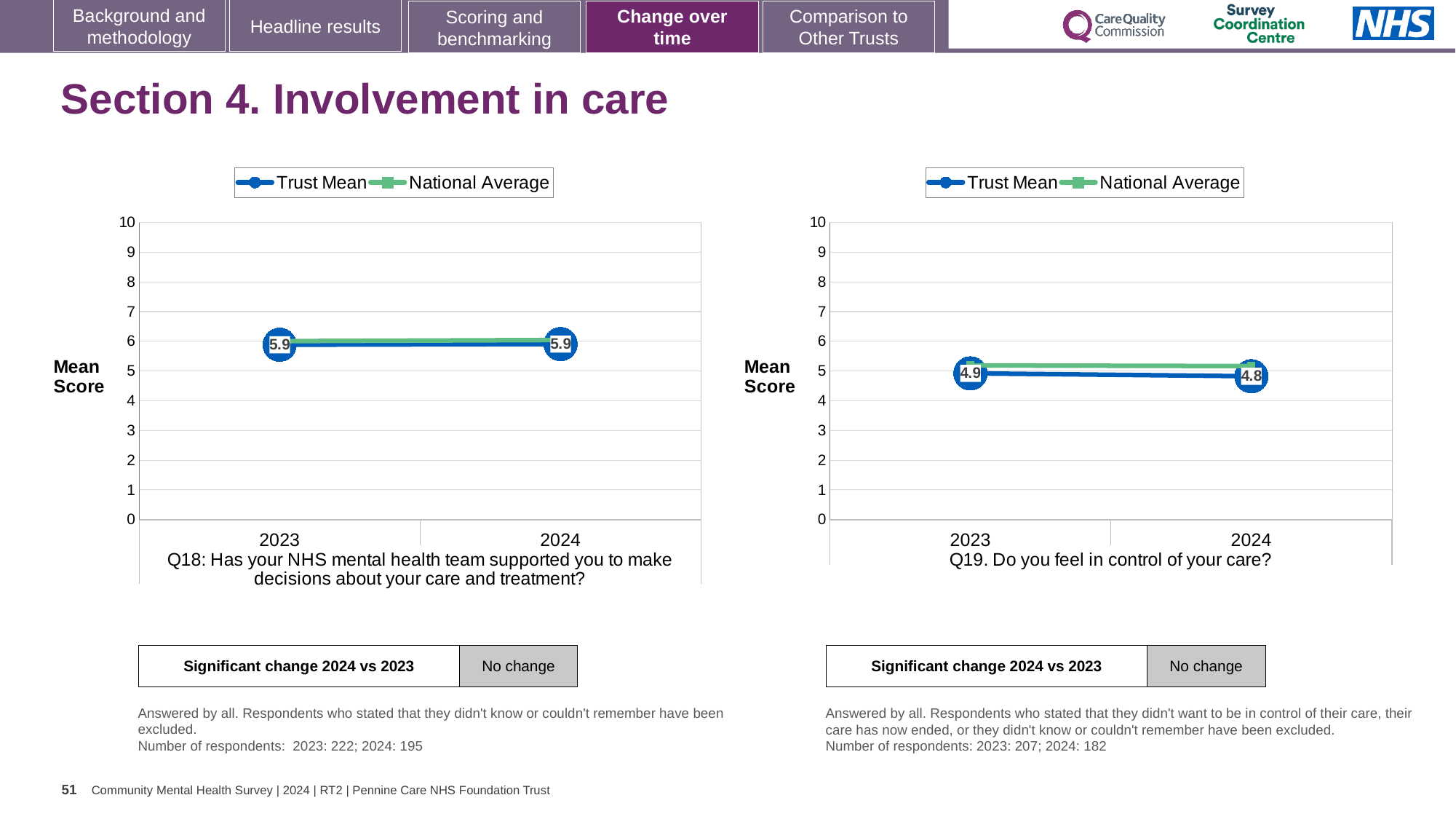
In the Q19 chart on the right, which year has the higher Trust Mean score, 2023 or 2024? 2023 In the Q18 chart on the left, what is the Trust Mean score for 2023? 5.9 In the Q19 chart on the right, what is the difference between the Trust Mean scores for 2023 and 2024? 0.1 In the Q19 chart on the right, which is higher in 2024, the Trust Mean or the National Average? National Average How many years are plotted on the x axis of the Q19 chart on the right? 2 In the Q19 chart on the right, what is the Trust Mean score for 2023? 4.9 In the Q19 chart on the right, what is the Trust Mean score for 2024? 4.8 In the Q19 chart on the right, does the Trust Mean rise, fall or stay the same from 2023 to 2024? fall In the Q18 chart on the left, what is the Trust Mean score for 2024? 5.9 How many series does the legend of the Q18 chart on the left list? 2 In the Q18 chart on the left, does the Trust Mean rise, fall or stay the same from 2023 to 2024? stay the same What kind of chart is the Q18 chart on the left? line chart